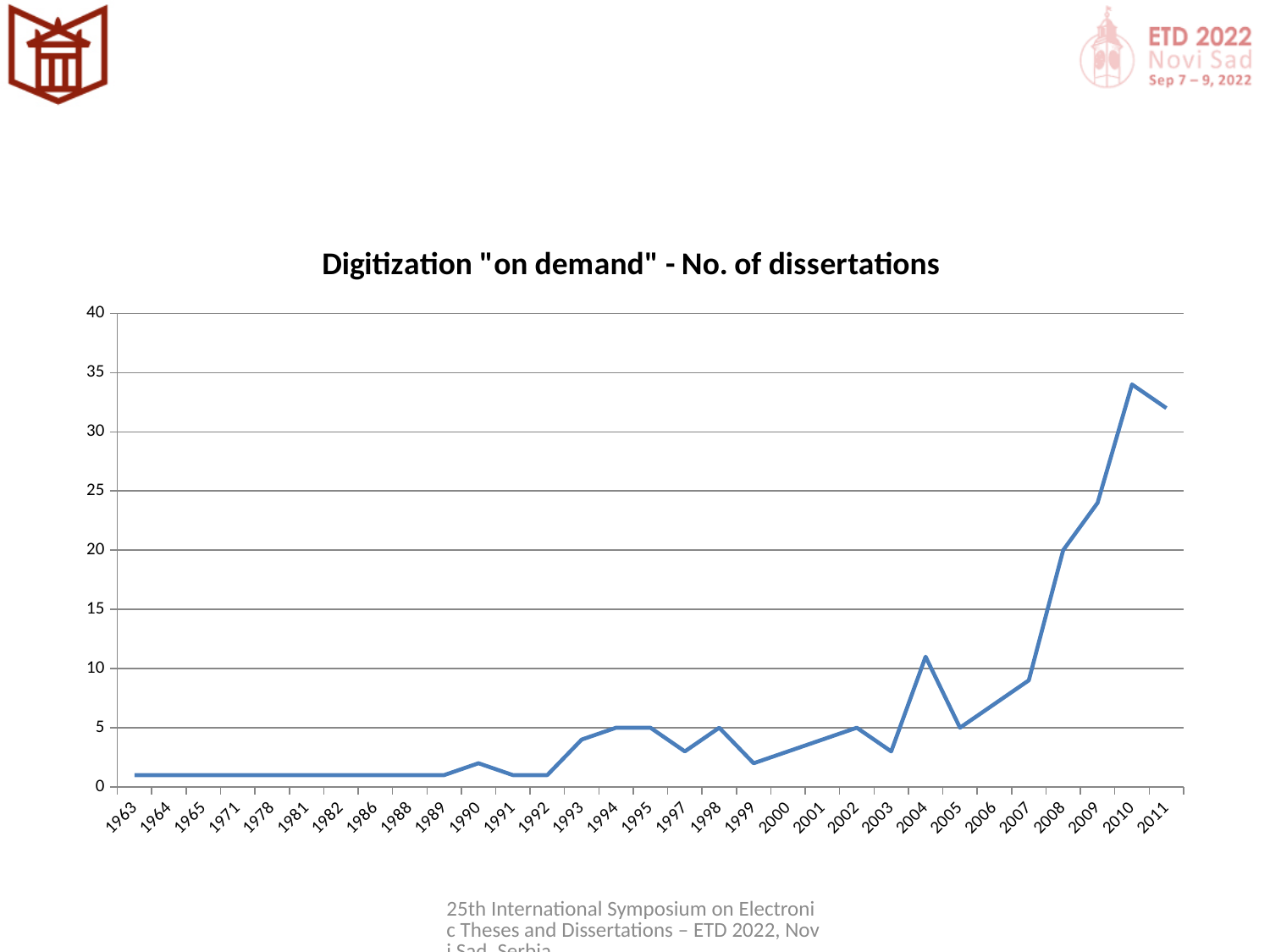
What is the value for 2008? 20 What type of chart is shown on the slide? line chart Is the value for 2007 greater or less than 10? less Is the value for 2010 greater or less than 30? greater Is the value for 2004 greater or less than 10? greater What is the value for 2005? 5 Do the values rise or fall from 2005 to 2010? rise Which year has the larger value, 2004 or 2008? 2008 What is the title of the chart? Digitization "on demand" - No. of dissertations How many years are plotted along the x axis? 31 Which year has the highest number of dissertations? 2010 What is the value for 1995? 5